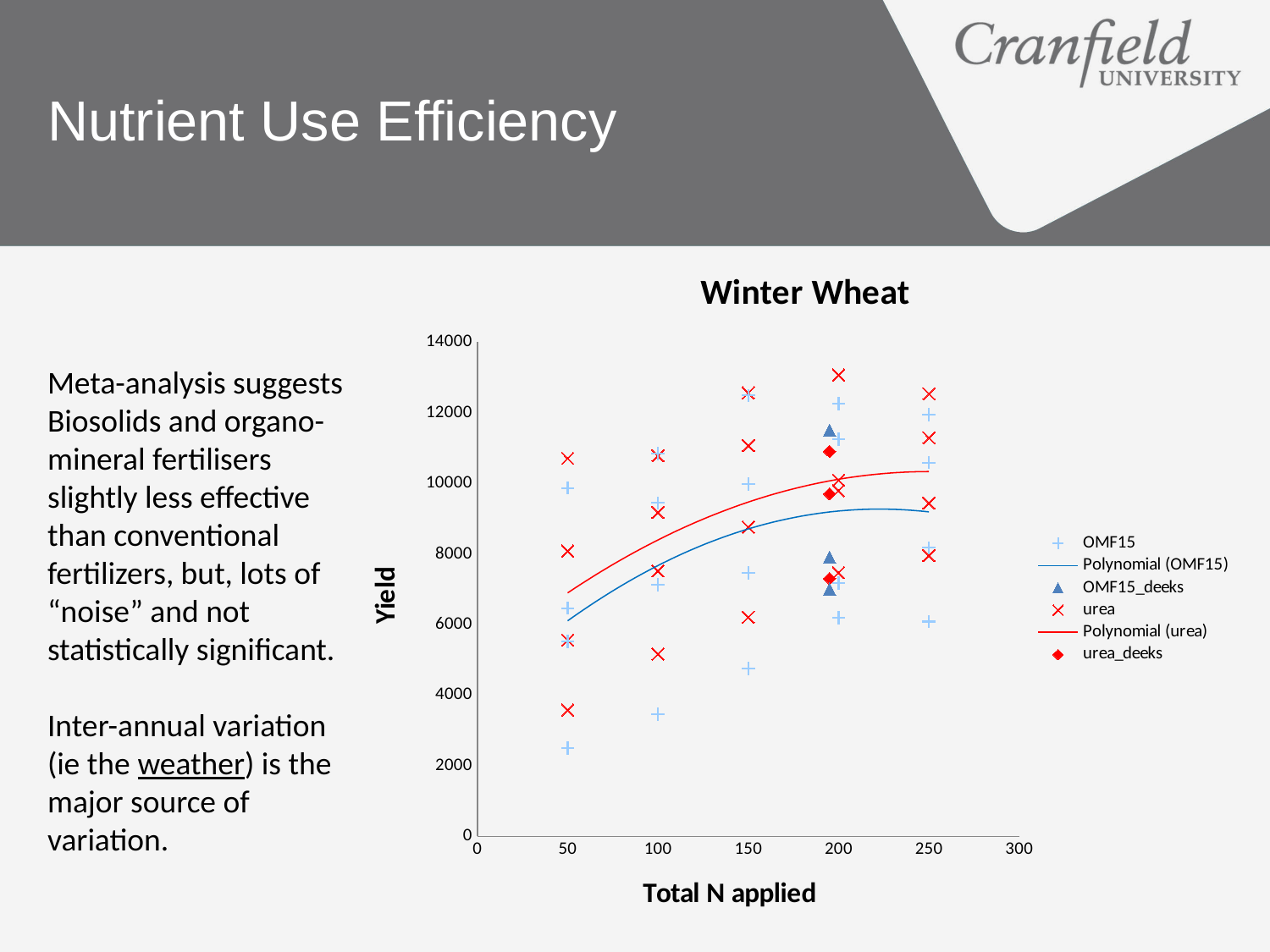
What kind of chart is shown on the slide? scatter chart How many series does the chart's legend list? 6 Is the lowest OMF15 point at Total N applied of 50 greater or less than 4000? less What is the label of the x axis? Total N applied Which trend line lies higher on the chart, Polynomial (urea) or Polynomial (OMF15)? Polynomial (urea) Is the lowest OMF15 point at Total N applied of 150 greater or less than 6000? less Is the lowest urea point at Total N applied of 50 greater or less than 4000? less What is the title of the chart? Winter Wheat Does the Polynomial (urea) trend line rise or fall as Total N applied increases from 50 to 250? rise What is the maximum value shown on the Yield axis? 14000